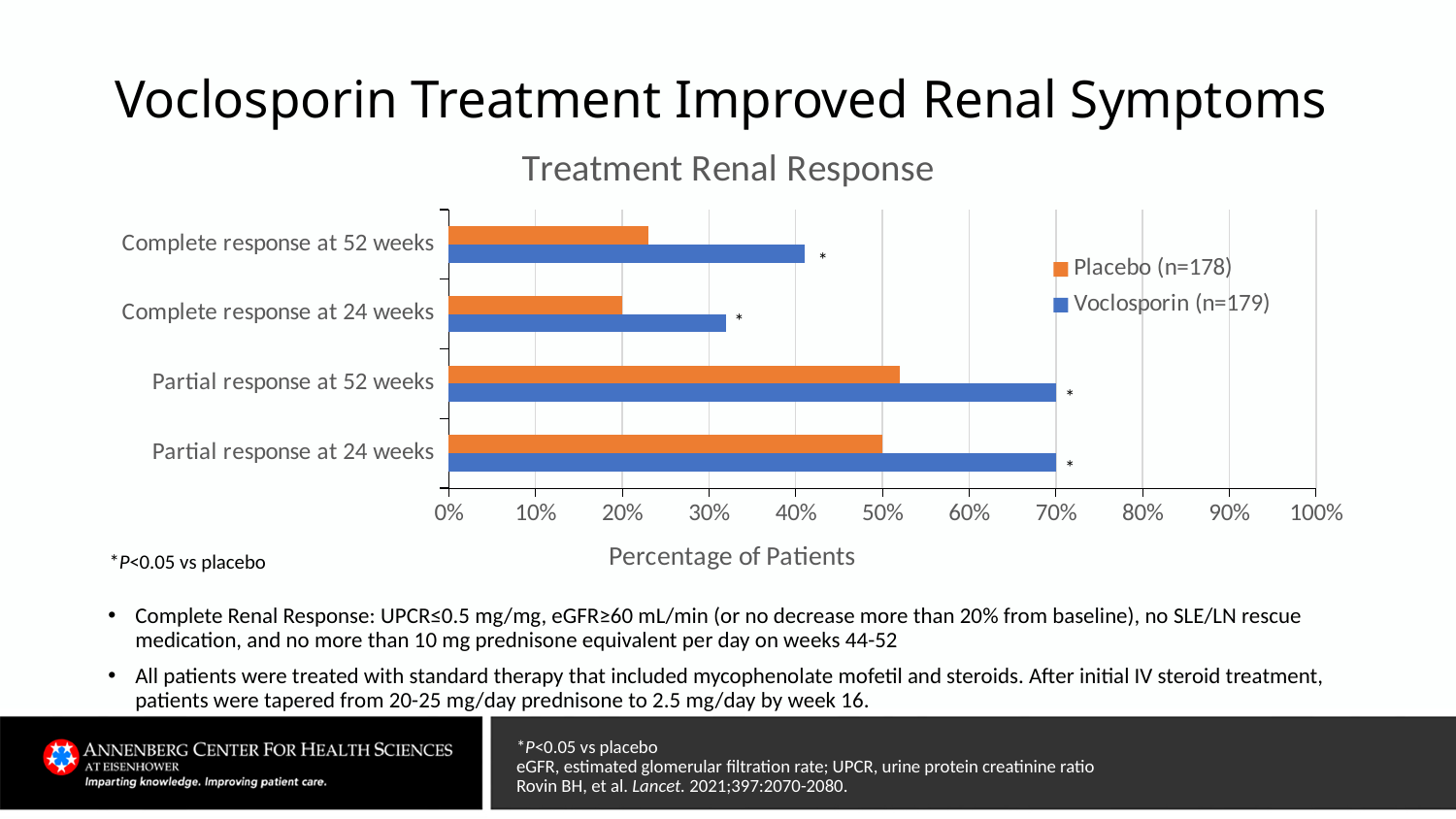
For Complete response at 52 weeks, which group has the larger value, Placebo or Voclosporin? Voclosporin Is the value for Placebo at Complete response at 52 weeks greater or less than 30%? less How many response categories are shown on the chart? 4 Which category has the lowest value for Voclosporin (n=179)? Complete response at 24 weeks Is the value for Voclosporin at Complete response at 52 weeks greater or less than 30%? greater How many series does the chart legend list? 2 Is the value for Voclosporin at Partial response at 52 weeks greater or less than 60%? greater For Partial response at 24 weeks, which group has the larger value, Placebo or Voclosporin? Voclosporin What type of chart is shown on the slide? Bar chart What is the label of the horizontal axis? Percentage of Patients What is the title of the chart? Treatment Renal Response